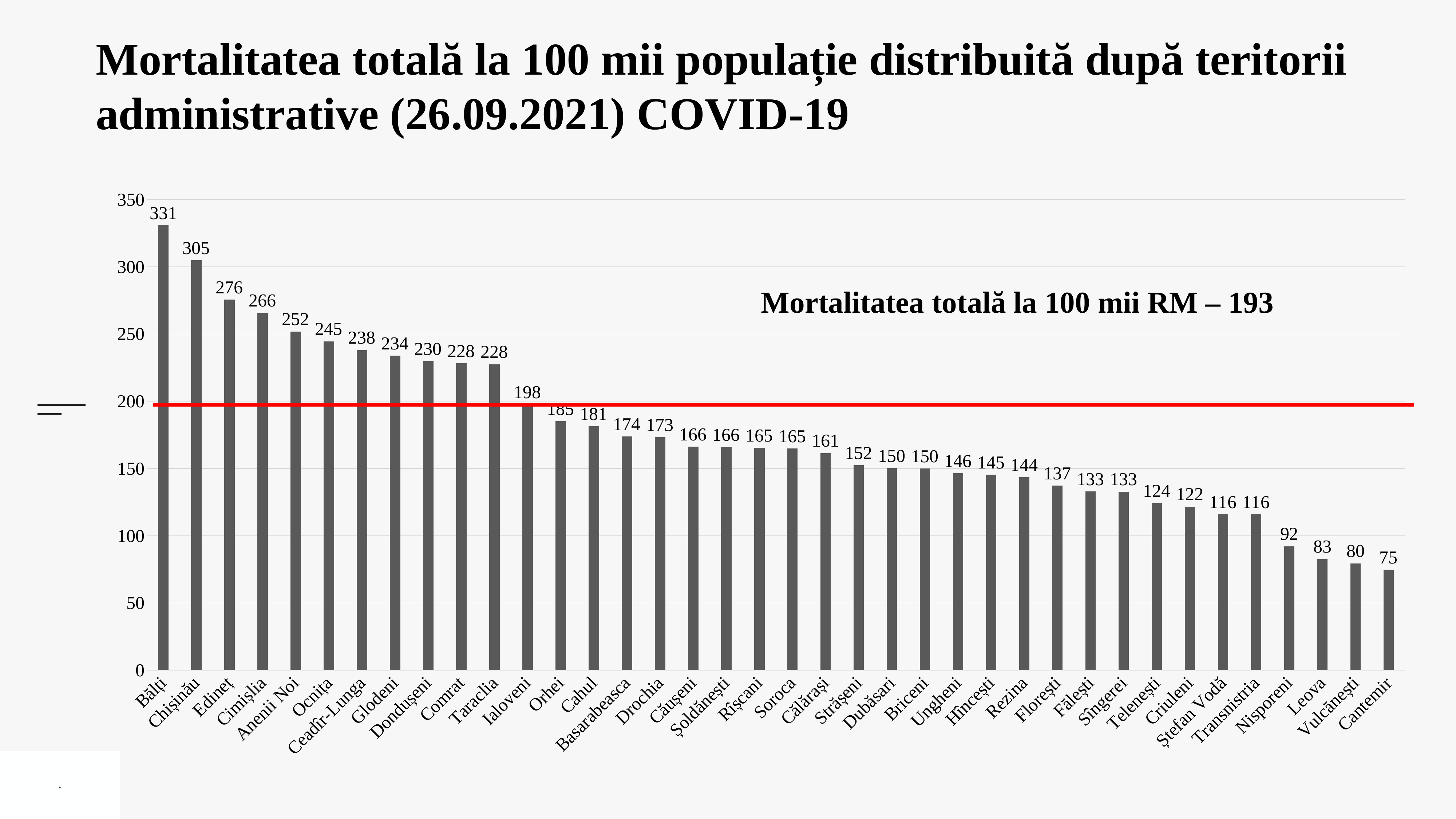
What is the value for Cahul? 181 Which territory has the lowest value? Cantemir What kind of chart is shown on the slide? bar chart What is the difference between the values for Bălți and Chișinău? 26 What value does the text on the chart give for total mortality per 100 thousand in RM? 193 Which territory has the highest value? Bălți How many territories are shown on the chart? 38 Which has a larger value, Edineț or Ocnița? Edineț Is the value for Ialoveni greater or less than 200? less What is the value for Chișinău? 305 What is the value for Transnistria? 116 What is the value for Bălți? 331